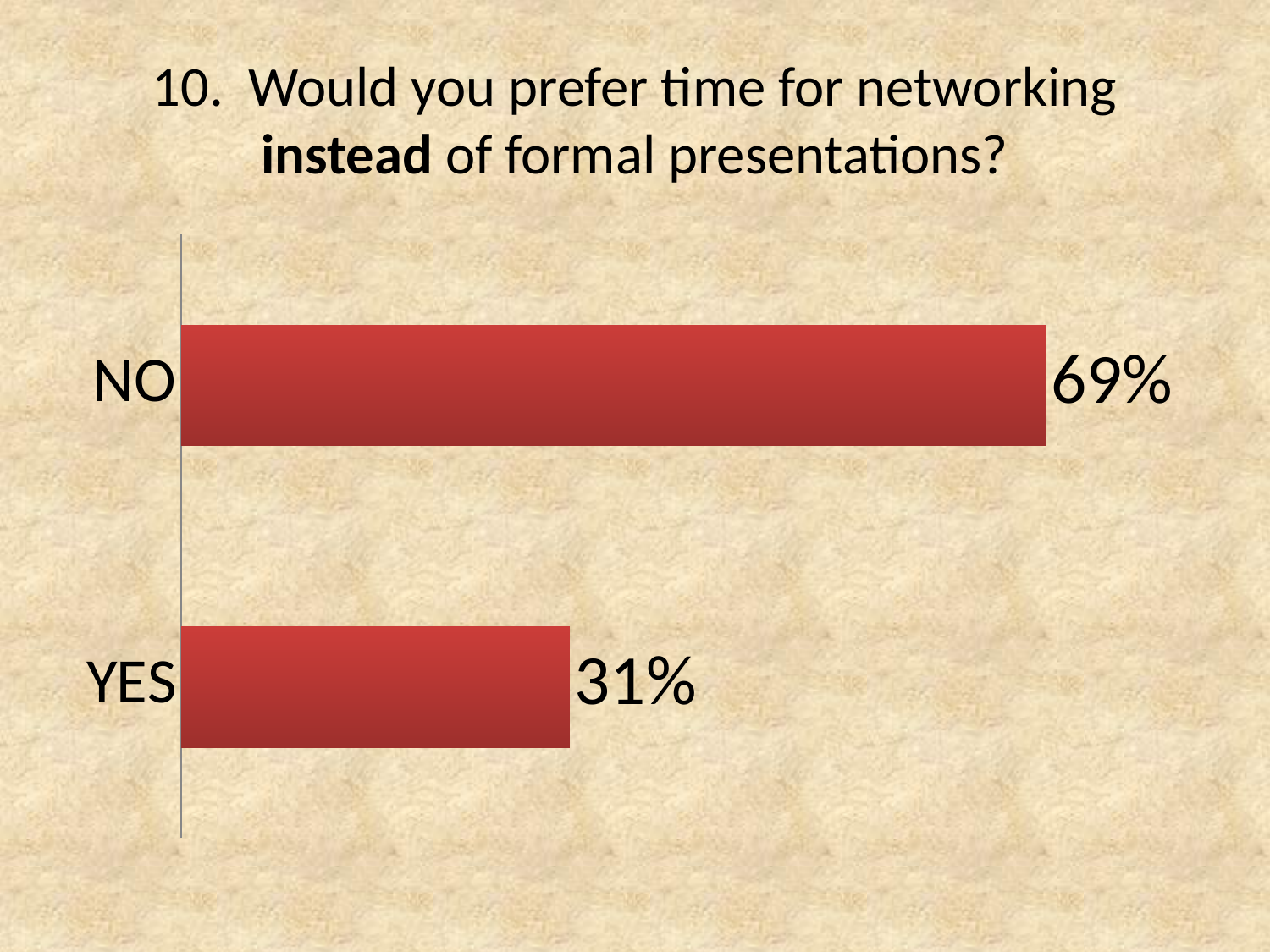
What kind of chart is shown on the slide? Bar chart What question does the chart on the slide present results for? 10. Would you prefer time for networking instead of formal presentations? What is the difference between the NO and YES percentages? 38% What percentage of respondents answered NO? 69% Which is larger, the value for NO or the value for YES? NO Which response has the highest value? NO What percentage of respondents answered YES? 31% What colour are the bars in the chart? Red How many response categories are shown in the chart? 2 Which response has the lowest value? YES What is the total of the NO and YES percentages? 100%